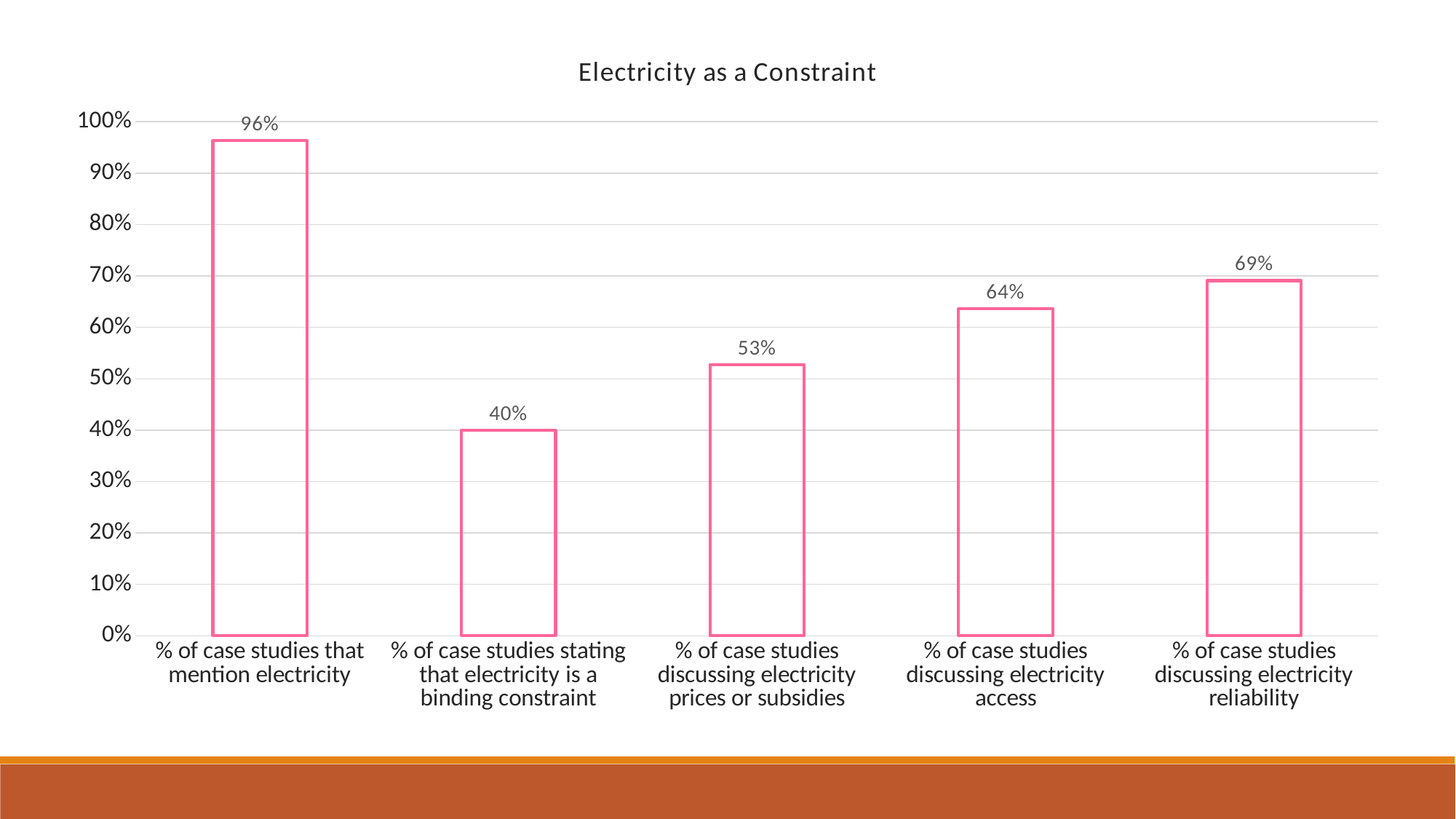
What percentage of case studies discuss electricity reliability? 69% Which category has the highest value? % of case studies that mention electricity What is the difference between the percentage of case studies that mention electricity and the percentage stating that electricity is a binding constraint? 56% Which category has the lowest value? % of case studies stating that electricity is a binding constraint What percentage of case studies discuss electricity access? 64% What kind of chart is shown on the slide? Bar chart Which is larger: the percentage of case studies discussing electricity access or the percentage discussing electricity reliability? % of case studies discussing electricity reliability What percentage of case studies mention electricity? 96% What percentage of case studies state that electricity is a binding constraint? 40% What percentage of case studies discuss electricity prices or subsidies? 53% How many categories are shown in the chart? 5 What is the title of the chart? Electricity as a Constraint